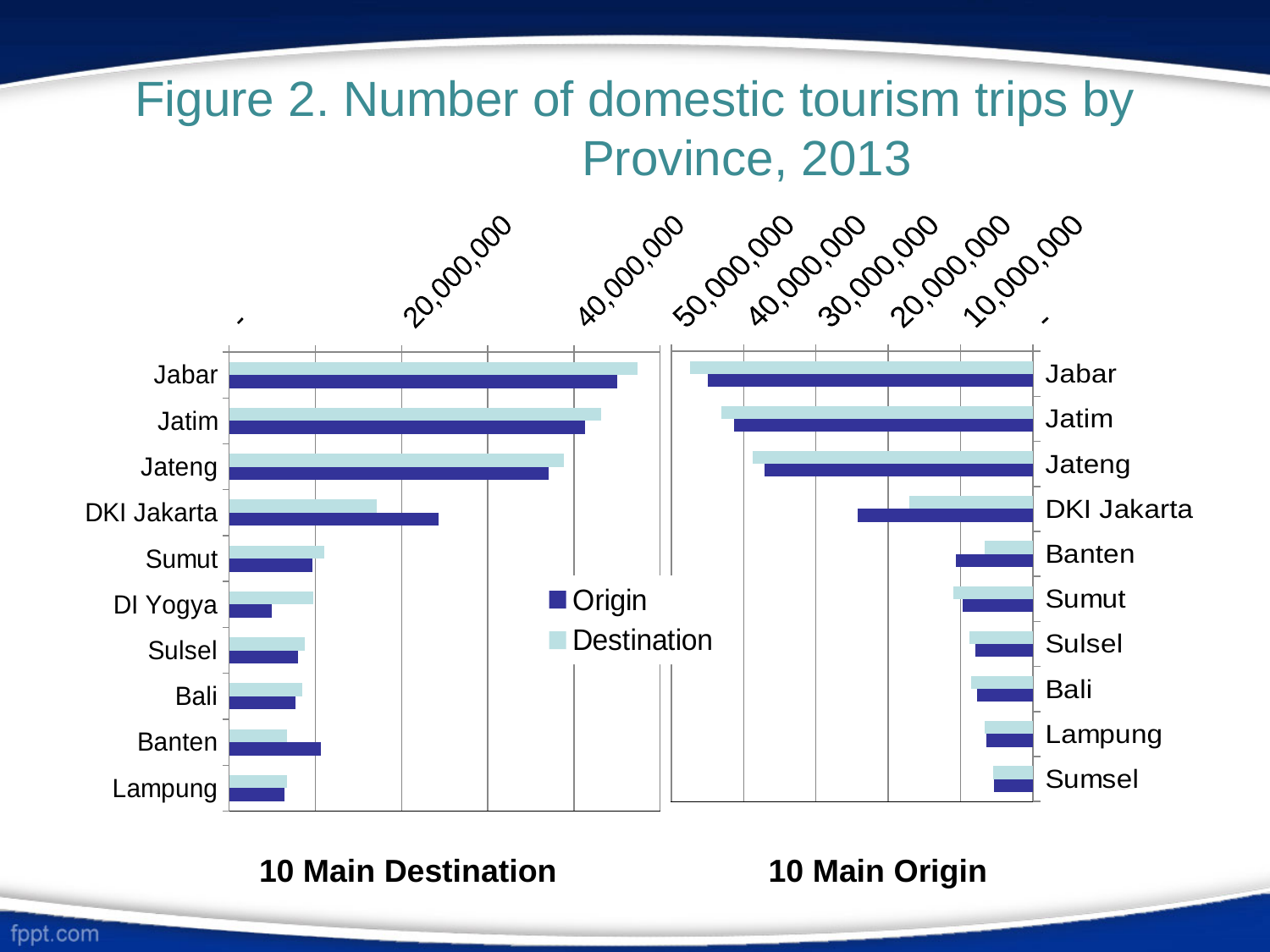
In the "10 Main Origin" chart, which province has the highest Origin value? Jabar What kind of chart is the "10 Main Destination" chart? bar chart In the "10 Main Destination" chart, is the Destination value for DKI Jakarta greater or less than 20,000,000? less How many series does the legend list? 2 In the "10 Main Destination" chart, for DKI Jakarta, which is larger: the Origin value or the Destination value? Origin In the "10 Main Destination" chart, which province has the highest Destination value? Jabar In the "10 Main Origin" chart, is the Origin value for Sumsel greater or less than 10,000,000? less What are the two series named in the legend? Origin and Destination In the "10 Main Destination" chart, which province has the lowest Origin value? DI Yogya In the "10 Main Origin" chart, is the Origin value for Jabar greater or less than 40,000,000? greater How many provinces are listed in the "10 Main Origin" chart? 10